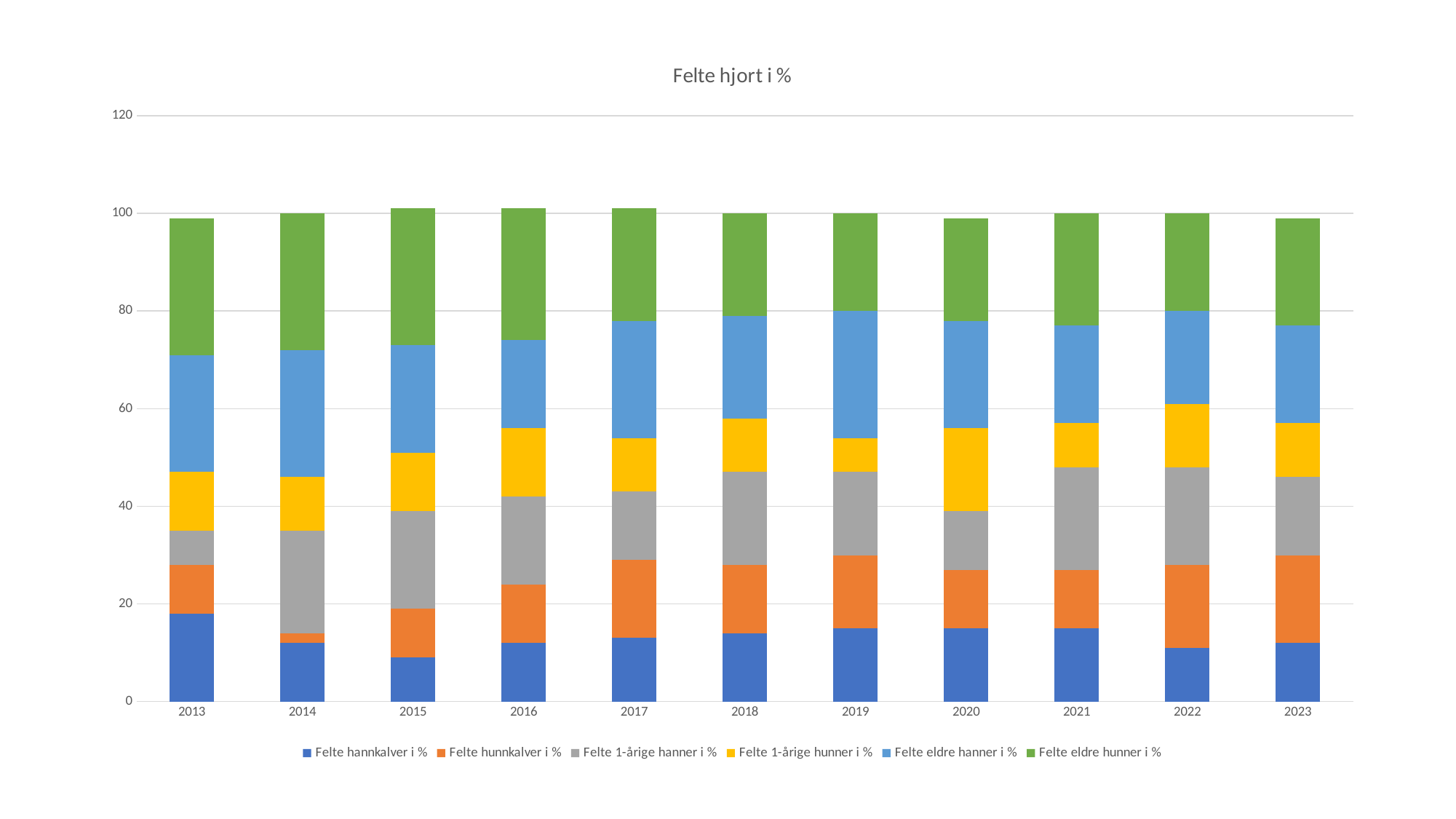
In which year is the value for Felte 1-årige hunner i % highest? 2020 Which year has a larger value for Felte hunnkalver i %, 2014 or 2023? 2023 What is the title of the chart? Felte hjort i % Is the value for Felte eldre hunner i % in 2013 greater or less than 20? greater Which series is shown in green in the legend? Felte eldre hunner i % Is the value for Felte hannkalver i % in 2015 greater or less than 20? less Is the value for Felte hunnkalver i % in 2014 greater or less than 20? less How many years are shown on the x axis? 11 What kind of chart is shown on the slide? Stacked bar chart Which year has a larger value for Felte hannkalver i %, 2013 or 2015? 2013 In which year is the value for Felte hunnkalver i % lowest? 2014 How many series does the legend list? 6